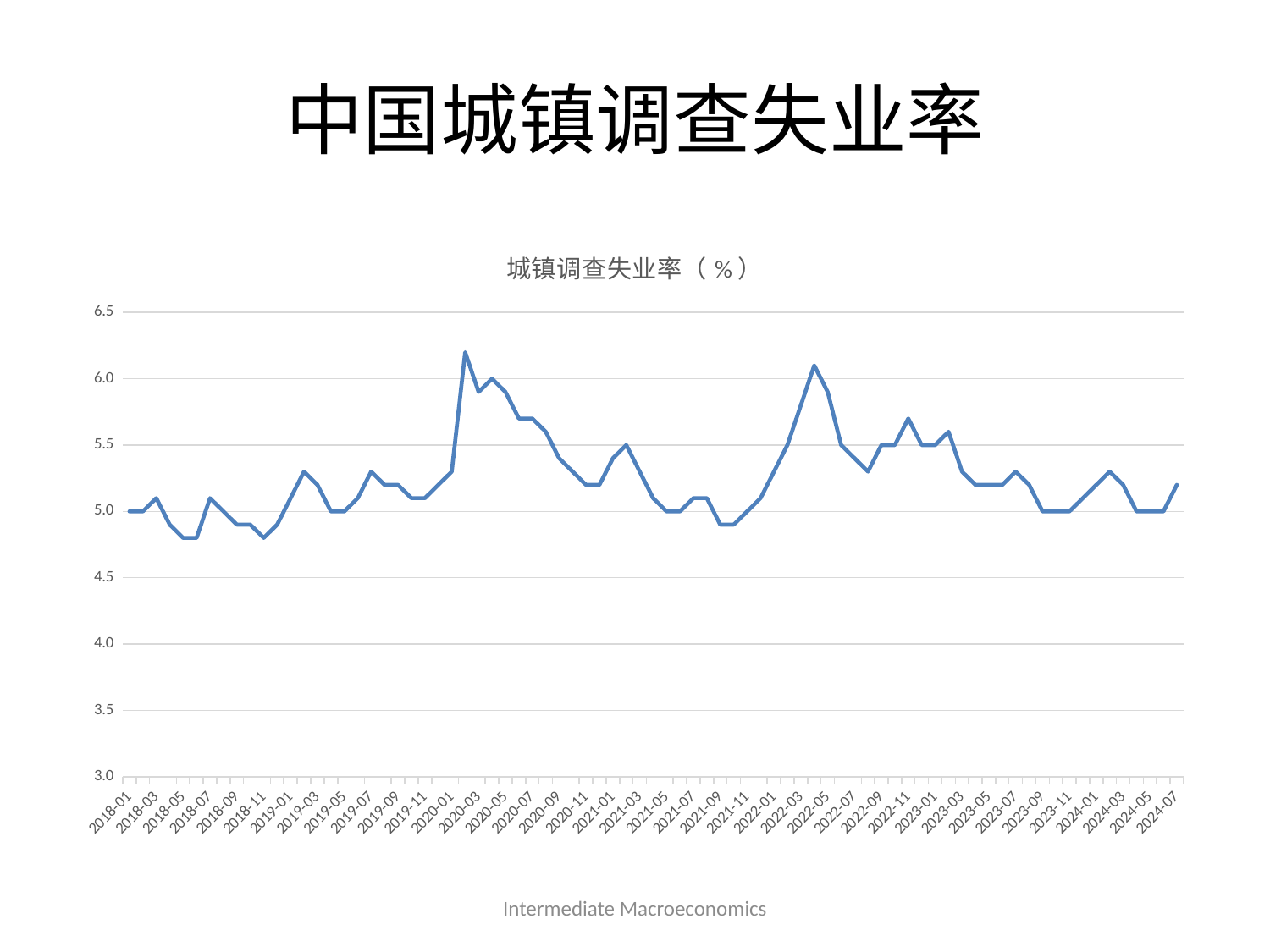
Does the value rise or fall from 2021-10 to 2022-04? rise What is the value for 2018-01? 5.0 Is the value for 2020-02 greater or less than 6.0? greater Is the value for 2022-04 greater or less than 6.0? greater Which is larger, the value for 2020-02 or the value for 2021-03? 2020-02 Is the value for 2018-05 greater or less than 5.0? less Does the value rise or fall from 2022-04 to 2022-07? fall What is the title of the chart? 城镇调查失业率（%） What kind of chart is shown on the slide? line chart